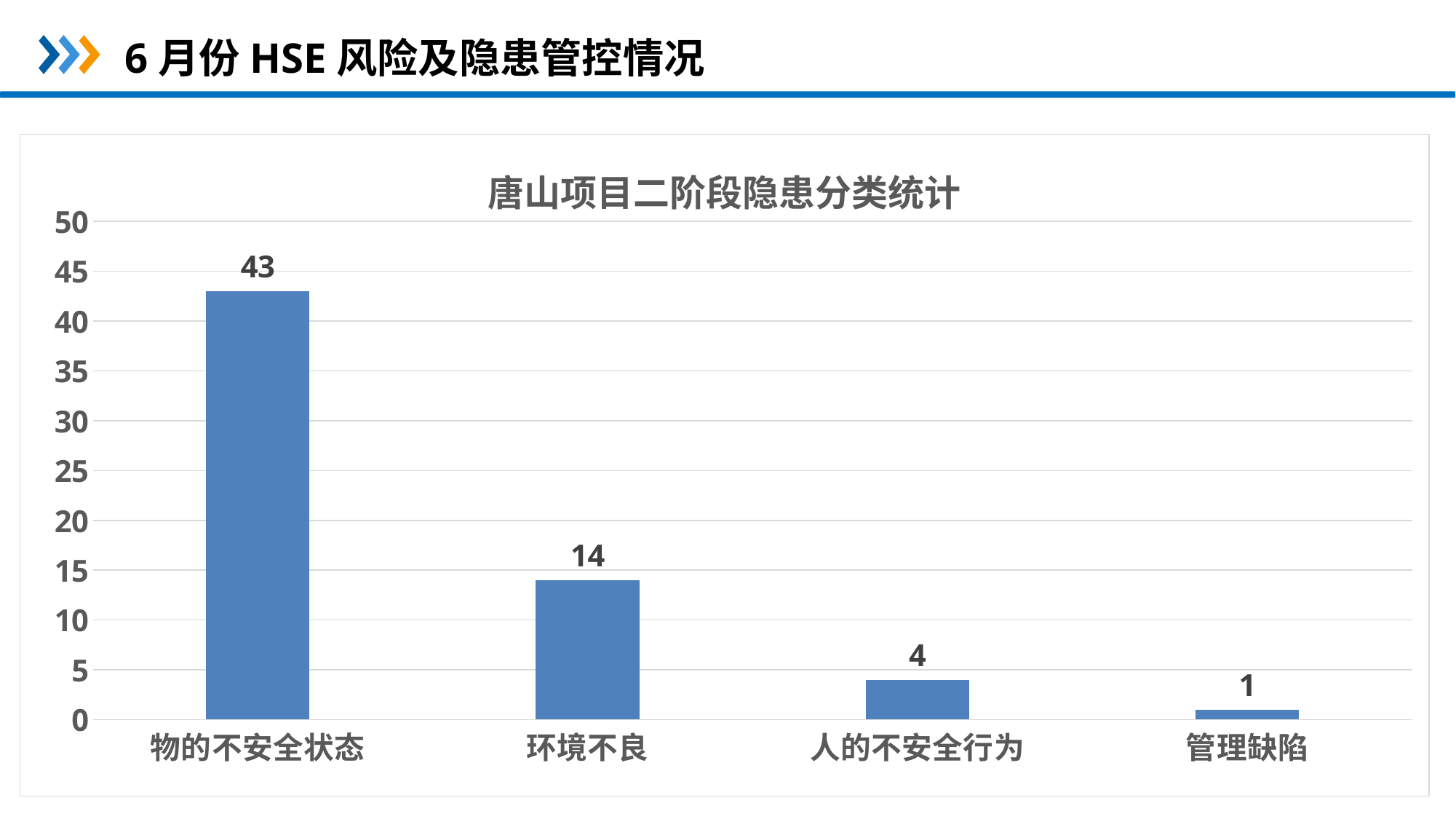
Is the value for 物的不安全状态 greater or less than 40? greater What is the value for 人的不安全行为? 4 Which is larger, the value for 环境不良 or the value for 人的不安全行为? 环境不良 What is the value for 环境不良? 14 Which category has the highest value? 物的不安全状态 Which category has the lowest value? 管理缺陷 What kind of chart is shown on the slide? bar chart What is the difference between the values for 物的不安全状态 and 环境不良? 29 What is the title of the chart? 唐山项目二阶段隐患分类统计 What is the value for 管理缺陷? 1 What is the value for 物的不安全状态? 43 How many categories are shown on the x axis? 4